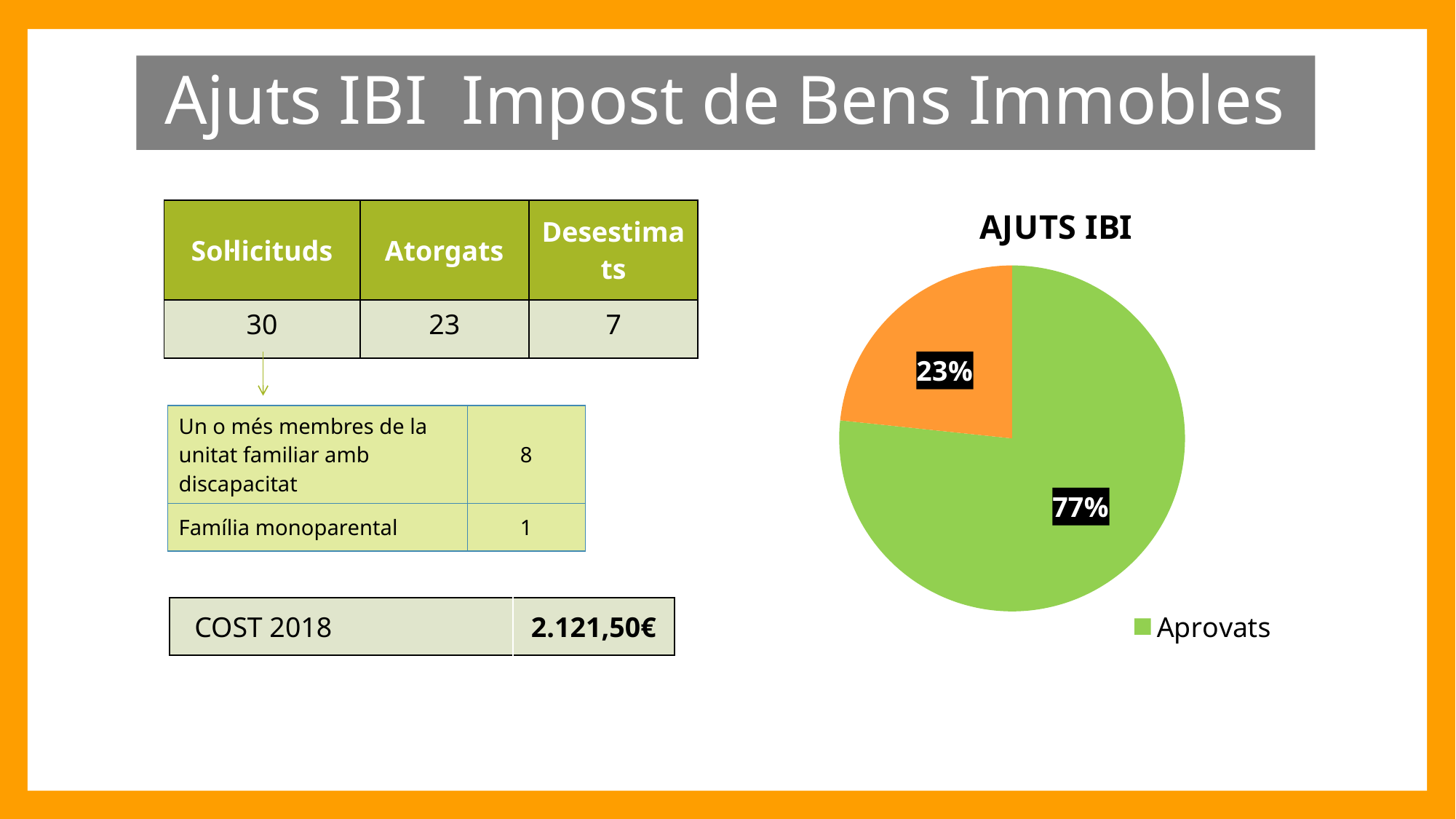
What colour is the Aprovats slice in the pie chart? green How many entries does the pie chart's legend list? 1 What kind of chart is shown on the slide? pie chart Which is larger in the pie chart, the green slice or the orange slice? the green slice By how many percentage points does the Aprovats slice exceed the orange slice? 54 What percentage is shown on the orange slice of the pie chart? 23% How many slices does the pie chart have? 2 What is the title of the pie chart? AJUTS IBI What share of the pie does the Aprovats slice represent? 77% Which slice of the pie chart is the largest? Aprovats Which slice of the pie chart is the smallest? the orange slice (23%)